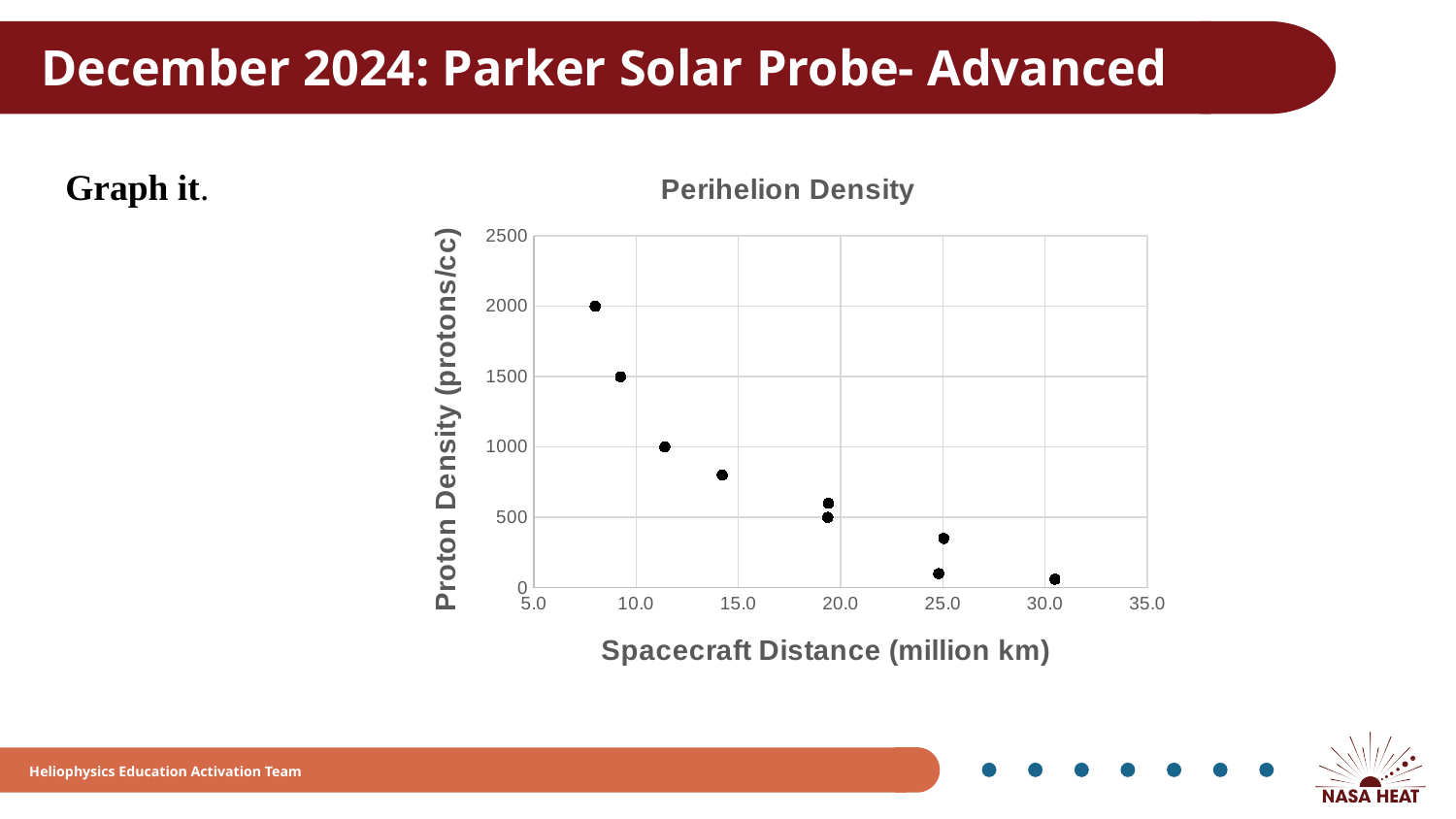
Does proton density rise or fall as spacecraft distance increases? Fall What is the proton density of the leftmost (highest) point on the chart? 2000 What is the label of the y axis of the chart? Proton Density (protons/cc) Is the proton density of the point near 14 million km greater or less than 1000? less Is the proton density of the rightmost point greater or less than 500? less What is the proton density of the second point from the left on the chart? 1500 What type of chart is shown on the slide? Scatter plot How many data points are plotted on the chart? 9 Which has the higher proton density: the point near 8 million km or the point near 30 million km? The point near 8 million km What is the title of the chart? Perihelion Density What is the proton density of the third point from the left on the chart? 1000 What is the maximum value shown on the y axis of the chart? 2500